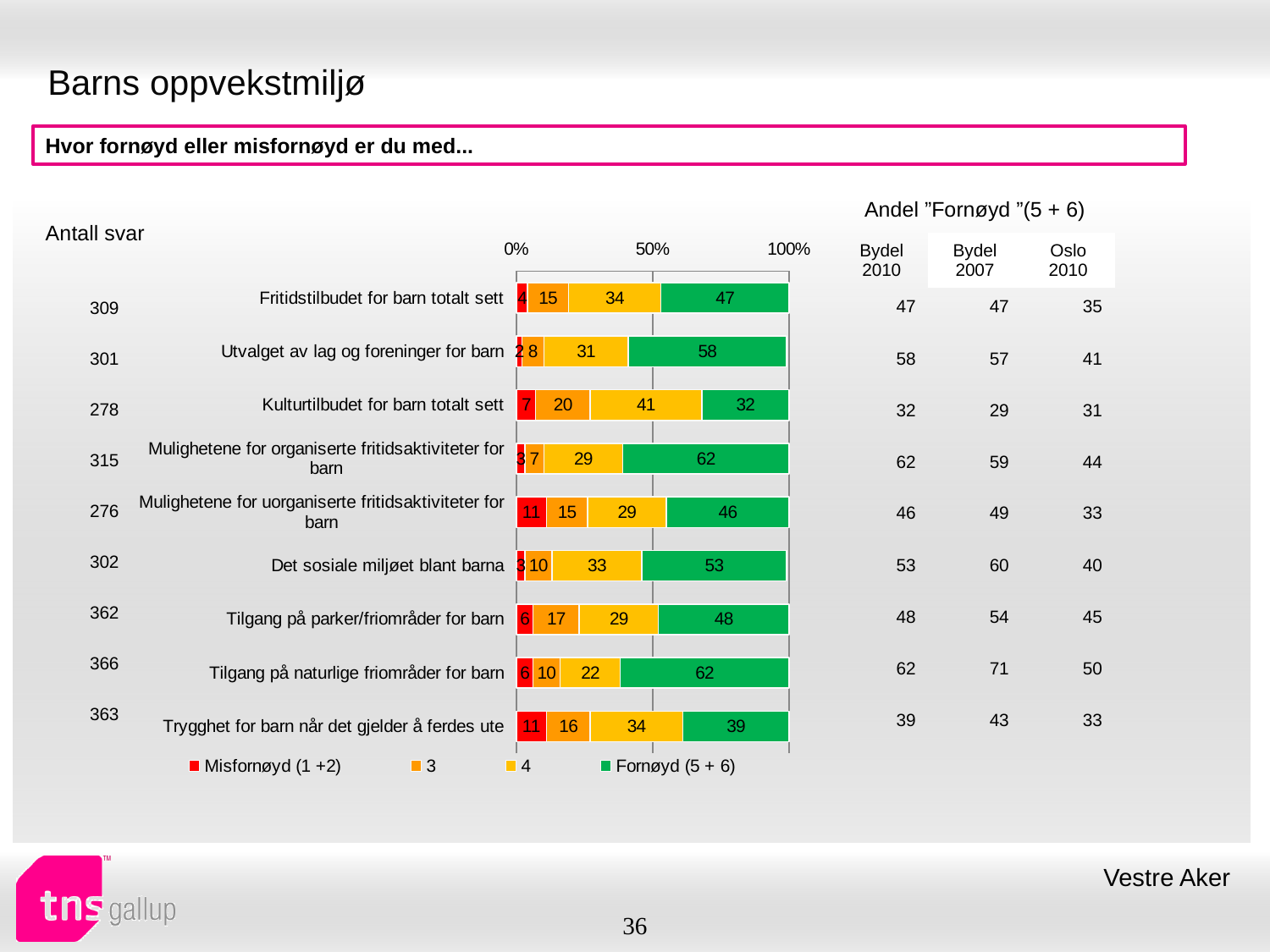
Which has a larger "Fornøyd (5 + 6)" value: "Det sosiale miljøet blant barna" or "Tilgang på parker/friområder for barn"? Det sosiale miljøet blant barna What is the "Misfornøyd (1 +2)" value for "Mulighetene for uorganiserte fritidsaktiviteter for barn"? 11 What is the "3" value for "Tilgang på parker/friområder for barn"? 17 What is the "4" value for "Trygghet for barn når det gjelder å ferdes ute"? 34 How many categories are plotted in the chart? 9 What is the "Fornøyd (5 + 6)" value for "Kulturtilbudet for barn totalt sett"? 32 Which category has the highest "4" value? Kulturtilbudet for barn totalt sett What is the total of the stacked bar for "Fritidstilbudet for barn totalt sett"? 100 Which category has the lowest "Fornøyd (5 + 6)" value? Kulturtilbudet for barn totalt sett What kind of chart is shown on the slide? bar chart How many series does the chart legend list? 4 What is the difference between the "Fornøyd (5 + 6)" values for "Utvalget av lag og foreninger for barn" and "Fritidstilbudet for barn totalt sett"? 11